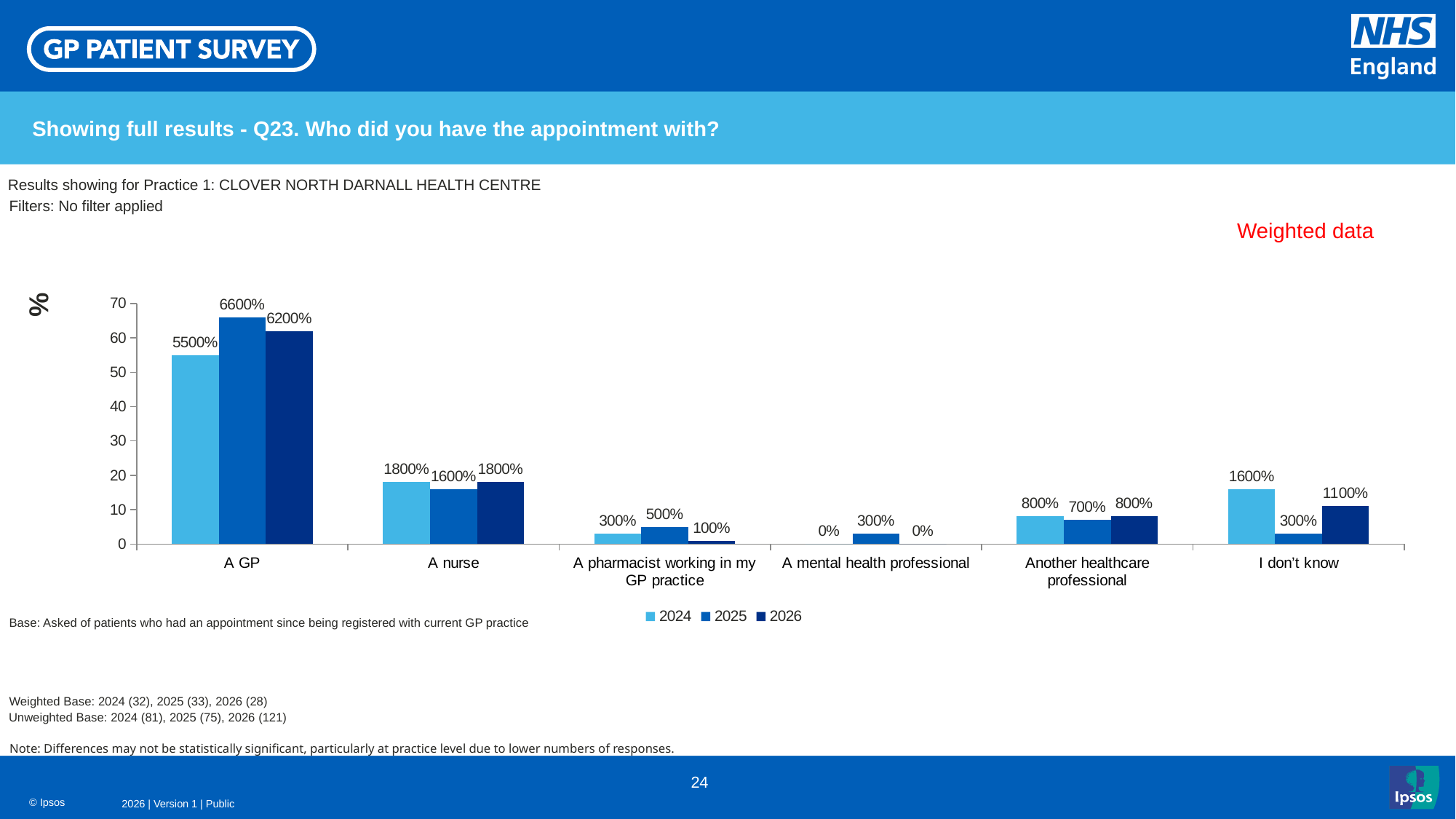
What is the difference between the 2025 and 2024 values for 'A GP'? 1100% How many categories are shown on the x axis? 6 Which category has the lowest value in the 2024 series? A mental health professional What is the value for 'A GP' in the 2025 series? 6600% What kind of chart is shown on the slide? bar chart Is the 2026 value for 'A GP' greater or less than 50 on the axis? greater Which category has the highest value in the 2025 series? A GP In the 2024 series, which is larger: 'A nurse' or 'I don't know'? A nurse What is the value for 'A nurse' in the 2024 series? 1800% What is the value for 'A mental health professional' in the 2025 series? 300% What is the value for 'I don't know' in the 2026 series? 1100% How many series does the legend list? 3